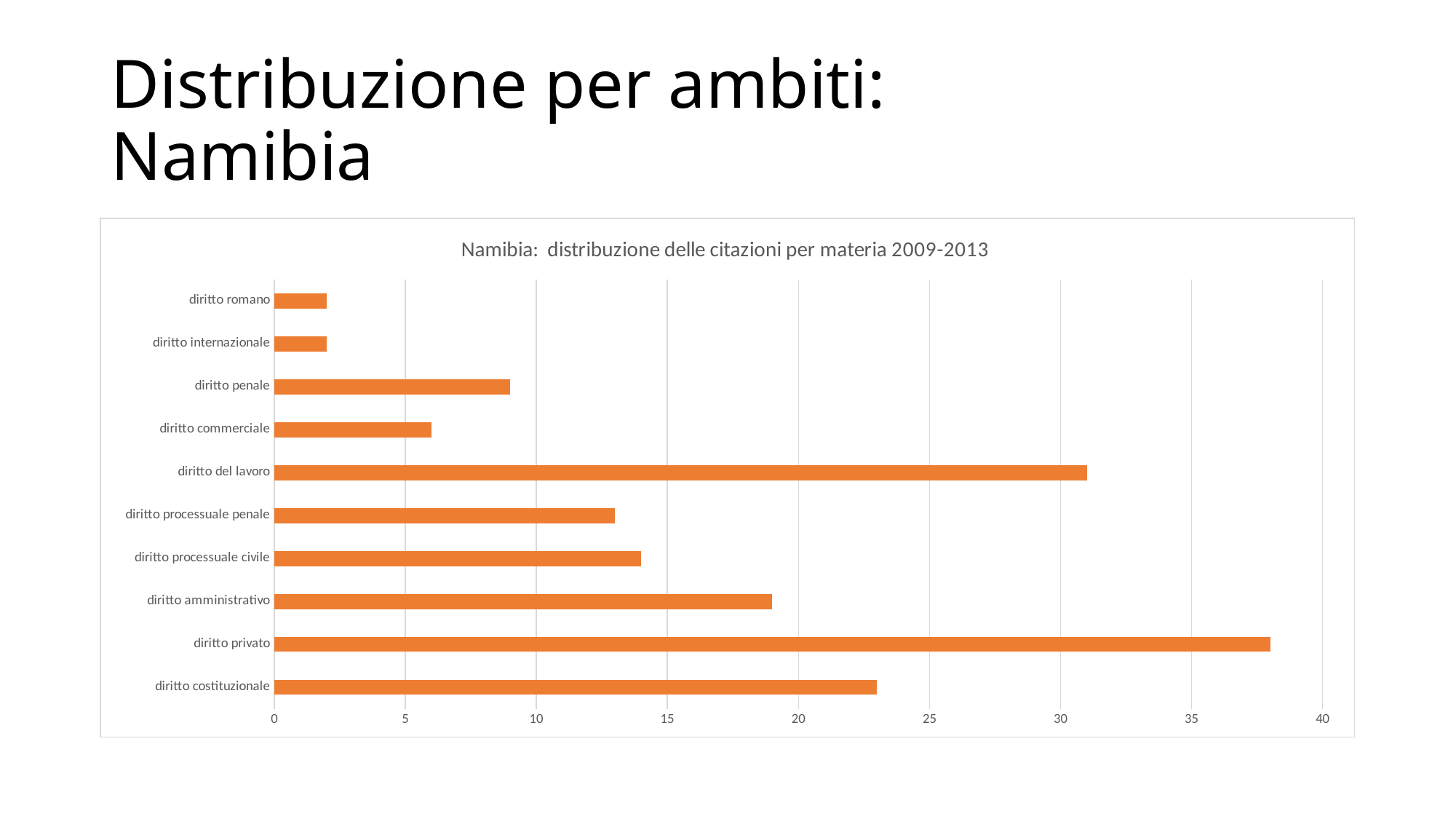
What is the title of the chart? Namibia: distribuzione delle citazioni per materia 2009-2013 How many categories (materie) are plotted in the chart? 10 What kind of chart is shown on the slide? bar chart What is the highest value shown on the horizontal axis? 40 Which is larger, the value for diritto amministrativo or the value for diritto processuale civile? diritto amministrativo Is the value for diritto amministrativo greater or less than 20? less Is the value for diritto romano greater or less than 5? less Is the value for diritto penale greater or less than 10? less Which category has the highest value? diritto privato Which is larger, the value for diritto del lavoro or the value for diritto costituzionale? diritto del lavoro